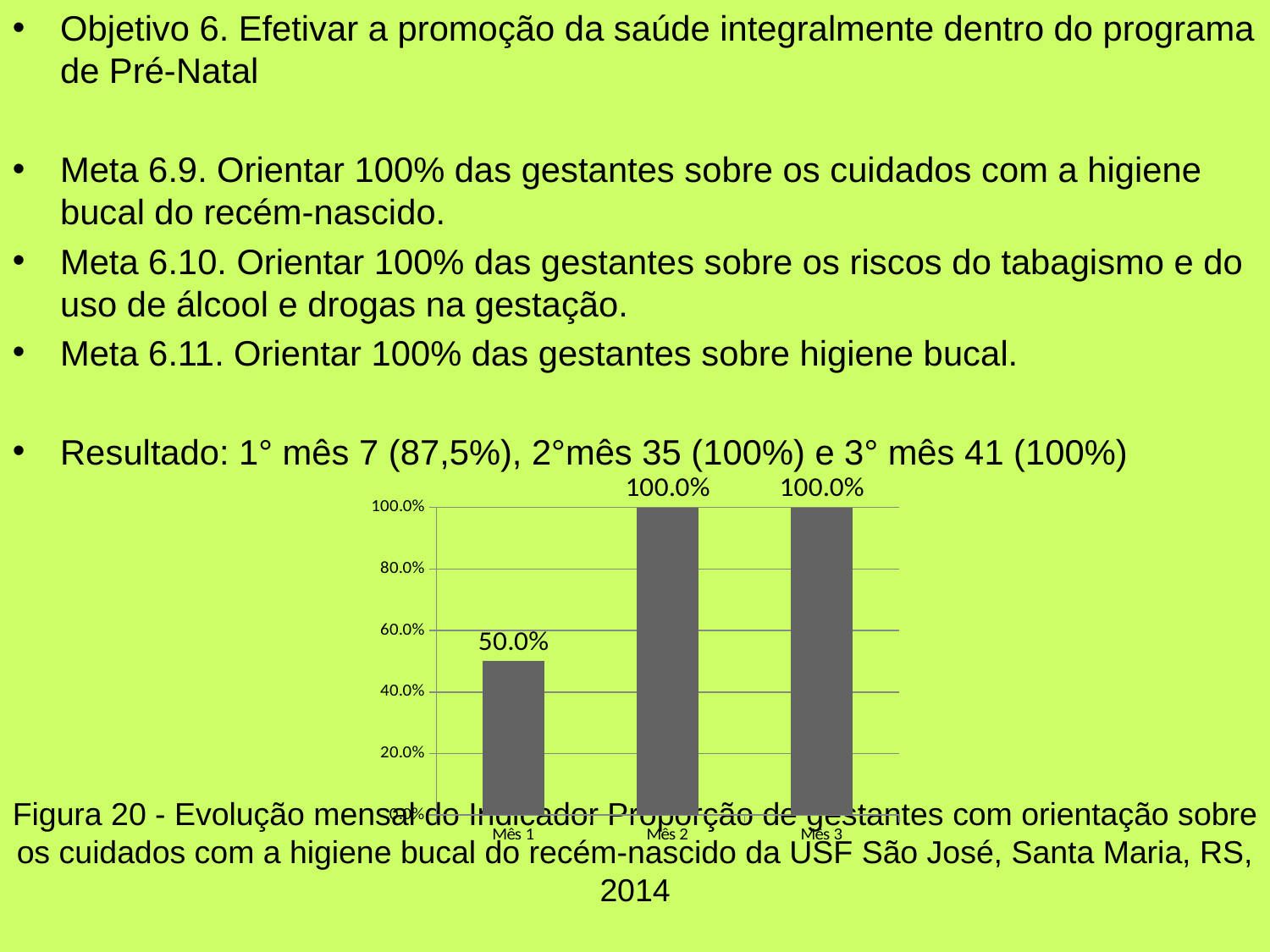
What is the value for Mês 2 in the chart? 100.0% Is the value for Mês 1 greater or less than 60.0%? less What is the value for Mês 1 in the chart? 50.0% Which is larger, the value for Mês 1 or the value for Mês 3? Mês 3 What is the difference between the values for Mês 2 and Mês 1? 50.0% What kind of chart is shown on the slide? bar chart What is the highest tick value shown on the vertical axis of the chart? 100.0% Which month has the lowest value in the chart? Mês 1 How many bars are plotted in the chart? 3 Is the value for Mês 2 greater or less than 80.0%? greater What is the value for Mês 3 in the chart? 100.0% Do the values rise or fall from Mês 1 to Mês 2? rise